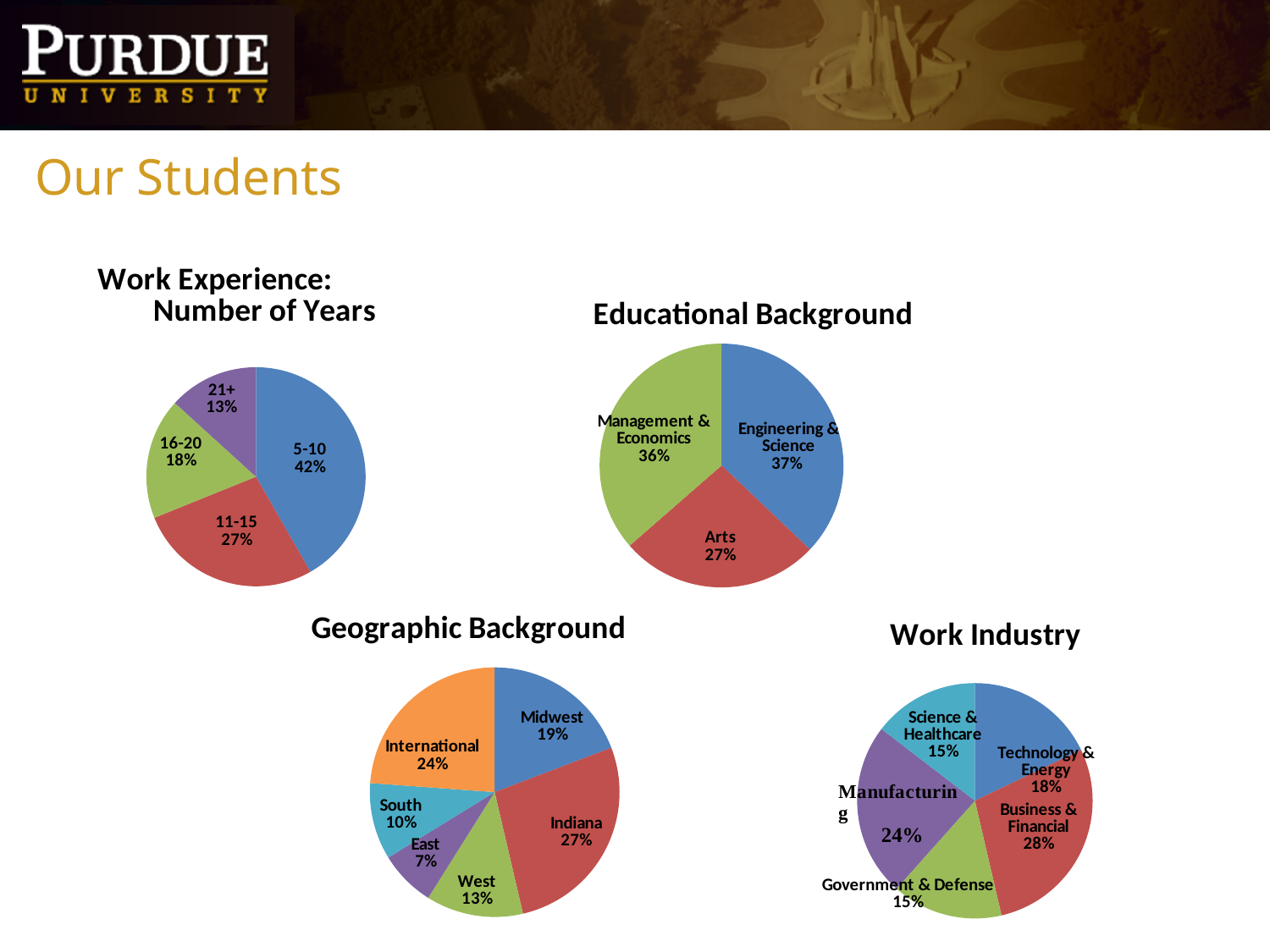
What type of chart is used for the Work Industry data? Pie chart In the Work Industry chart, what is the difference between the Manufacturing share and the Technology & Energy share? 6% In the Geographic Background chart, what share of students are from the East? 7% In the Work Experience: Number of Years chart, how many categories are shown? 4 In the Educational Background chart, what share of students have an Arts background? 27% In the Geographic Background chart, which region has the largest share? Indiana In the Work Experience: Number of Years chart, which category has the smallest share? 21+ In the Geographic Background chart, how many categories are shown? 6 In the Geographic Background chart, which is larger, the International share or the Midwest share? International In the Educational Background chart, what is the difference between the Engineering & Science share and the Management & Economics share? 1% In the Work Experience: Number of Years chart, what share of students have 5-10 years of experience? 42% In the Work Industry chart, what share of students come from Business & Financial? 28%